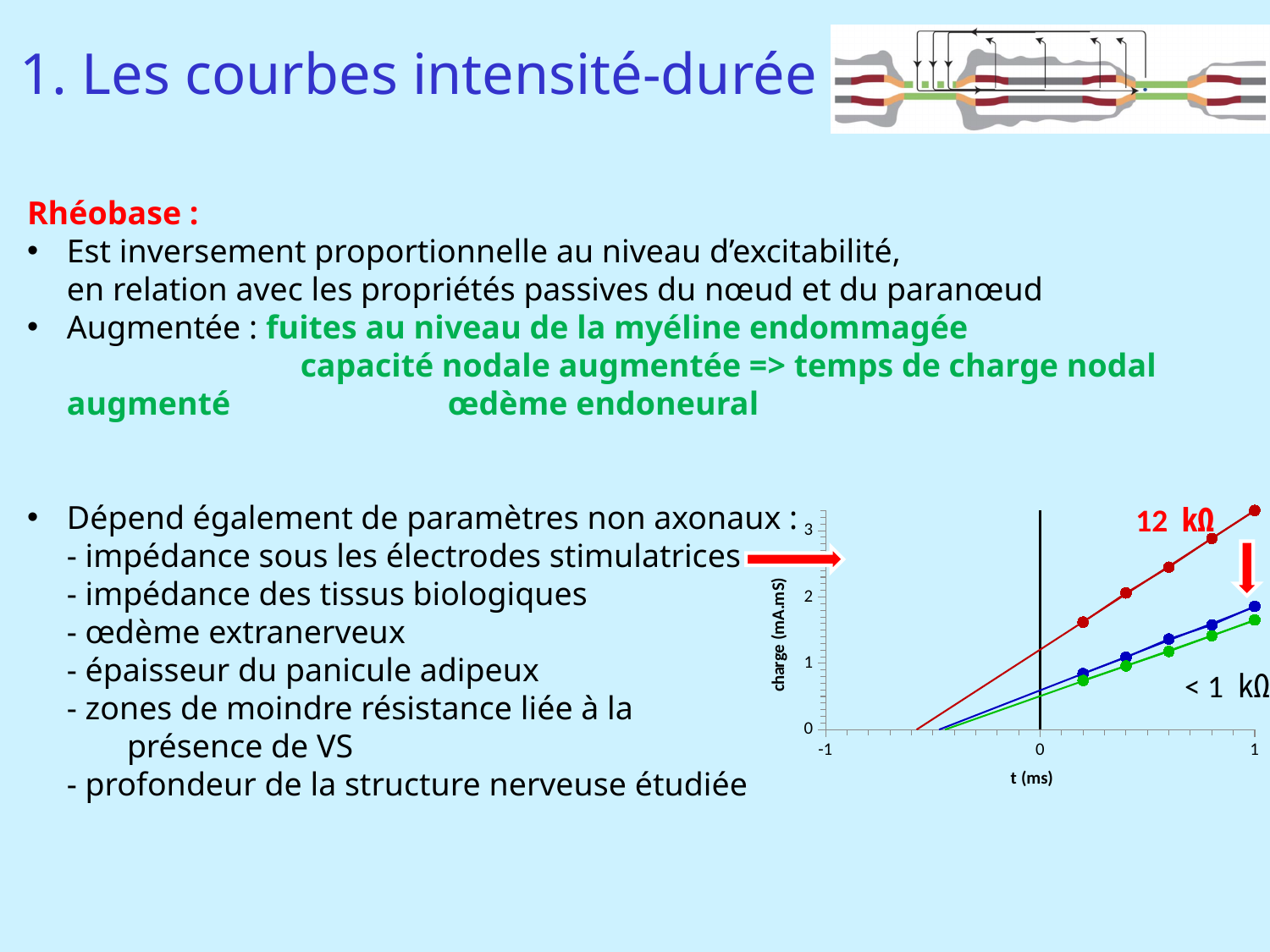
How many lines (series) are plotted on the chart? 3 What is the label of the x axis of the chart? t (ms) What kind of chart is shown on the slide? line chart Is the value of the red line at t = 0.2 greater or less than 1? greater Do the values of the red line rise or fall as t increases? rise What is the label of the y axis of the chart? charge (mA.mS) Which coloured line has the lowest values on the chart? green Which coloured line has the highest values on the chart? red How many data points are marked on the red line? 5 At t = 1, which line has the larger value, the red line or the green line? red Is the value of the blue line at t = 1 greater or less than 2? less Is the value of the red line at t = 1 greater or less than 3? greater